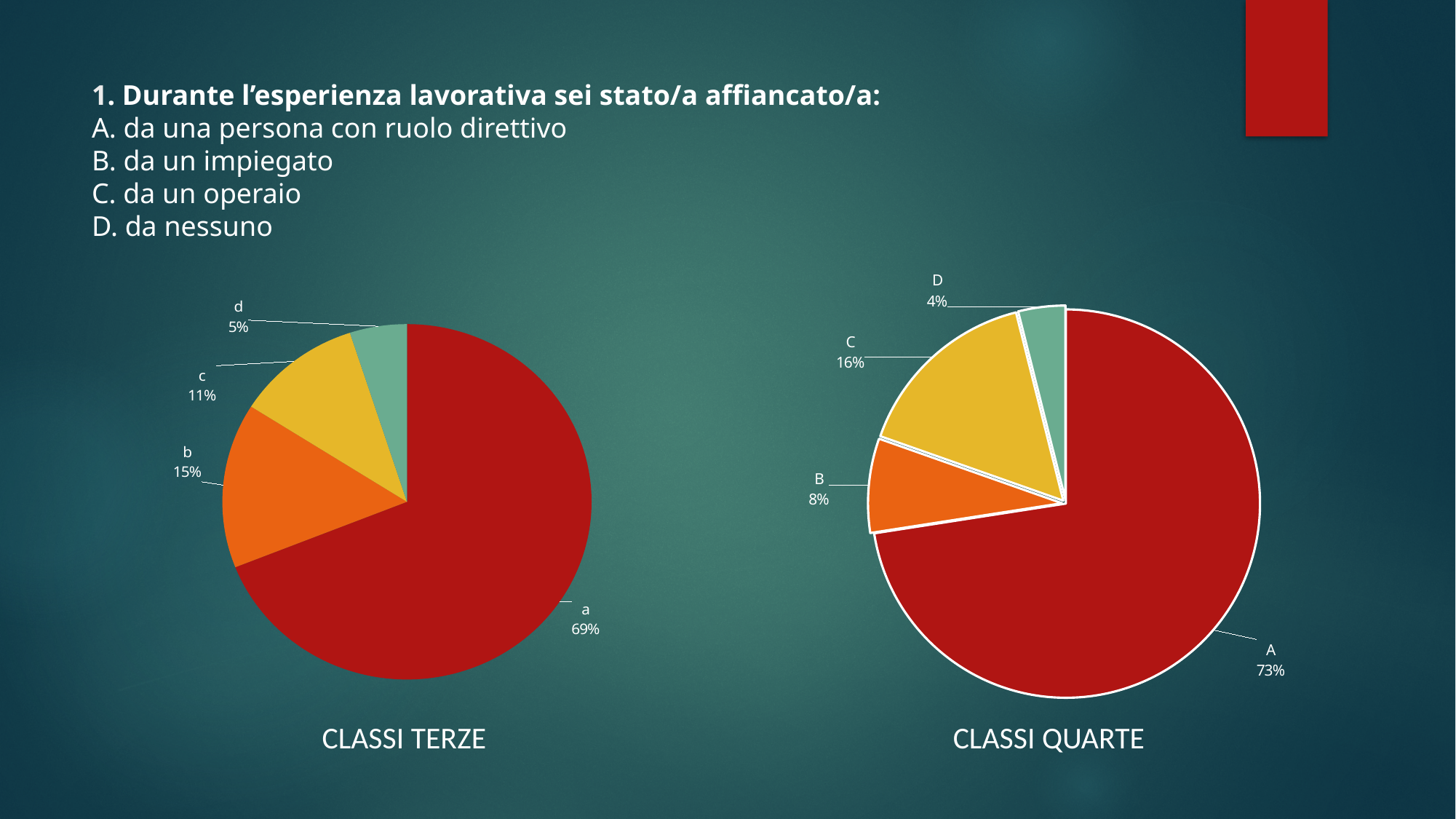
In the CLASSI TERZE chart, what is the share for slice a? 69% In the CLASSI TERZE chart, which is larger, slice c or slice d? c In the CLASSI QUARTE chart, what is the difference between slice C and slice B? 8% In the CLASSI TERZE chart, which slice is the largest? a In the CLASSI QUARTE chart, what is the share for slice C? 16% In the CLASSI QUARTE chart, what is the share for slice D? 4% What colour is the largest slice in the CLASSI QUARTE chart? red In the CLASSI QUARTE chart, which slice is the smallest? D What kind of chart is the CLASSI TERZE chart? pie chart In the CLASSI TERZE chart, what is the share for slice b? 15% In the CLASSI TERZE chart, what is the difference between slice a and slice b? 54% How many slices does the CLASSI QUARTE chart have? 4